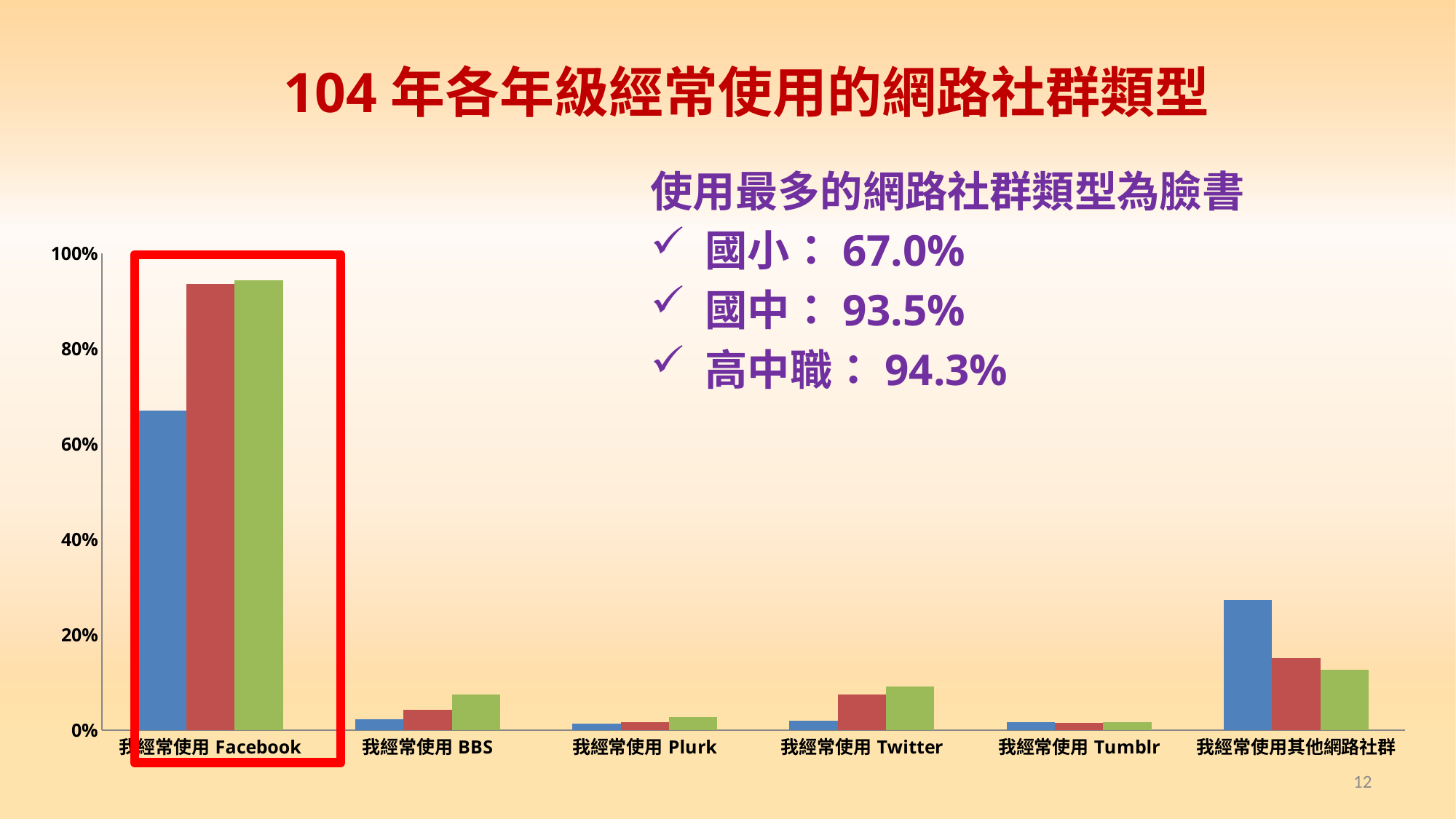
What is the difference between the 高中職 and 國小 values for 我經常使用 Facebook? 27.3% Is the blue bar for 我經常使用其他網路社群 greater or less than 20%? greater According to the slide, what is the value for 國小 in the 我經常使用 Facebook category? 67.0% How many categories are shown along the x axis of the chart? 6 Which category has the highest bars in the chart? 我經常使用 Facebook Is the red bar for 我經常使用其他網路社群 greater or less than 20%? less Which is larger: the blue bar for 我經常使用 Facebook or the blue bar for 我經常使用其他網路社群? 我經常使用 Facebook How many bars are plotted for each category in the chart? 3 According to the slide, what is the value for 高中職 in the 我經常使用 Facebook category? 94.3% Which category on the chart is highlighted with a red box? 我經常使用 Facebook What kind of chart is shown on the slide? bar chart According to the slide, what is the value for 國中 in the 我經常使用 Facebook category? 93.5%